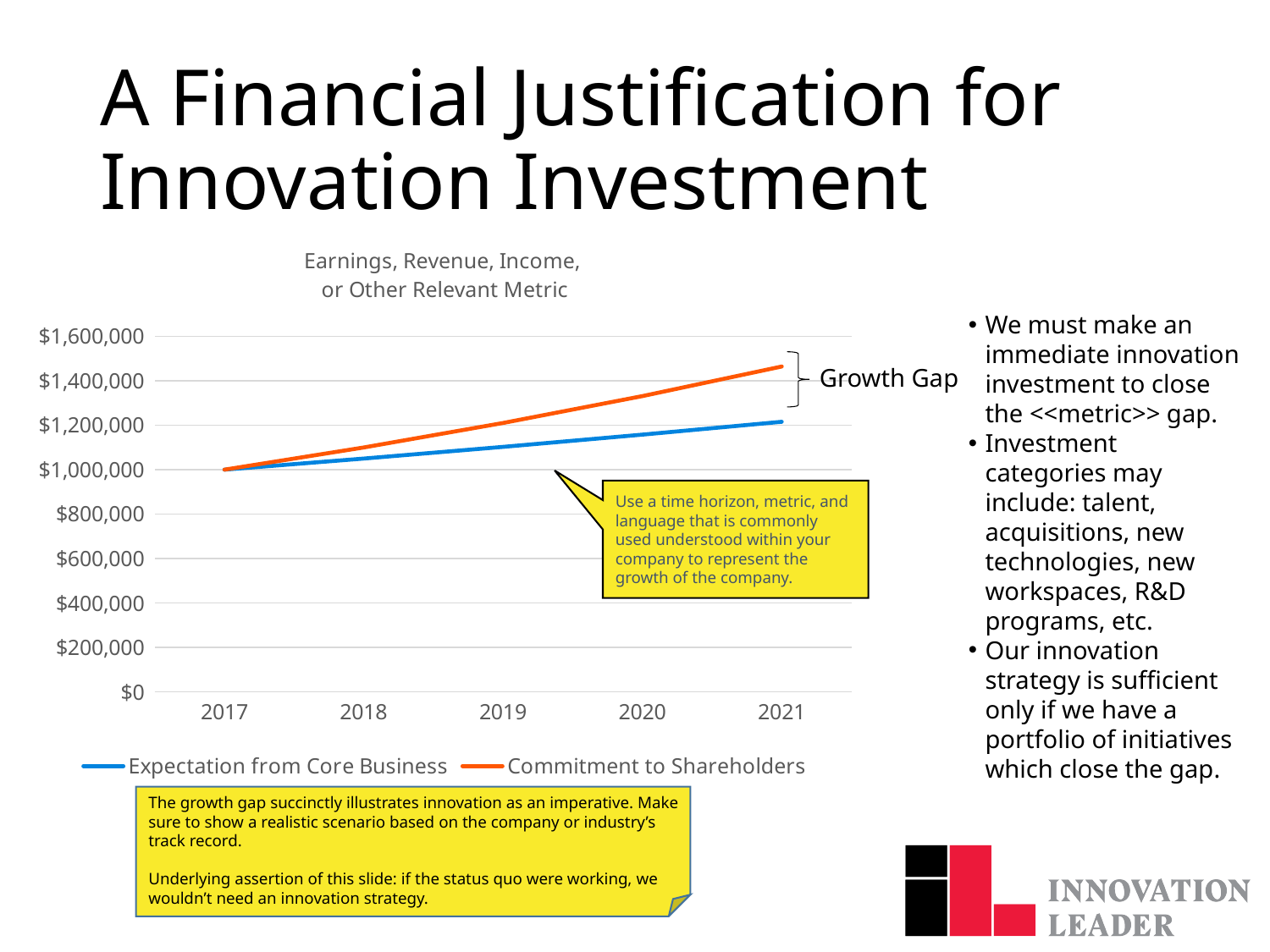
Is the value for Commitment to Shareholders in 2021 greater or less than $1,400,000? greater Is the value for Expectation from Core Business in 2021 greater or less than $1,400,000? less Does the Expectation from Core Business line rise or fall from 2017 to 2021? rise In 2021, which series has the higher value: Expectation from Core Business or Commitment to Shareholders? Commitment to Shareholders What is the value of Expectation from Core Business in 2017? $1,000,000 Which series is drawn in orange in the chart? Commitment to Shareholders What is the title of the chart? Earnings, Revenue, Income, or Other Relevant Metric Does the Commitment to Shareholders line rise or fall from 2017 to 2021? rise How many series does the chart legend list? 2 What kind of chart is shown on the slide? line chart What is the value of Commitment to Shareholders in 2017? $1,000,000 How many years are shown on the x axis of the chart? 5